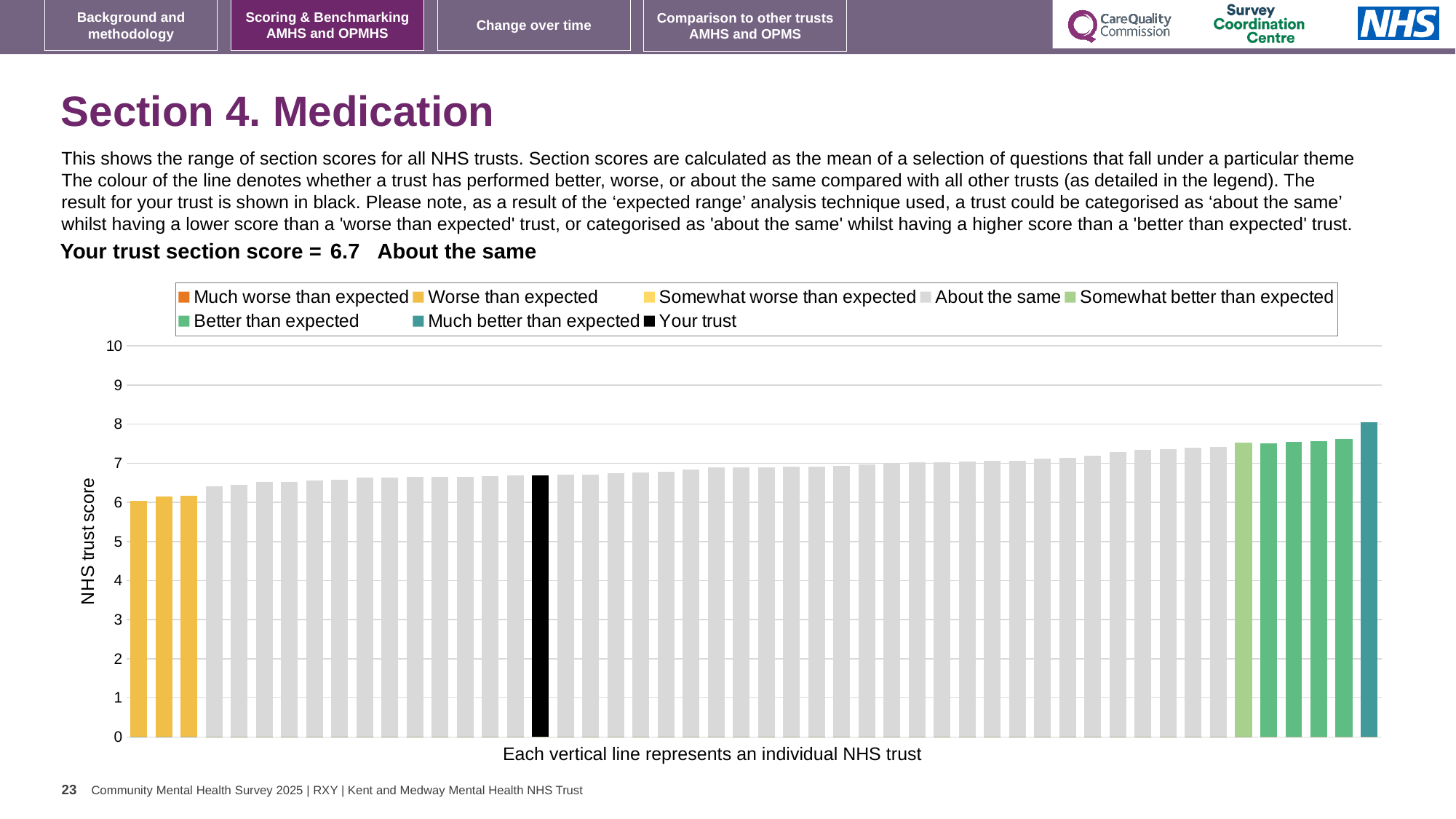
Is the value of the shortest bar (the leftmost bar) greater or less than 7? less How many bars are coloured as 'Worse than expected' (yellow)? 3 What is the section score for your trust shown on the slide? 6.7 Which category is your trust placed in for this section? About the same What is the label on the vertical axis of the chart? NHS trust score How many bars are coloured as 'Much better than expected' (teal)? 1 Do the bar values rise or fall from left to right along the x axis? rise Is the value of the tallest bar (the rightmost, teal bar) greater or less than 7? greater Is the value of the black bar (your trust) greater or less than 5? greater What kind of chart is shown on the slide? bar chart Which is larger, the leftmost bar or the rightmost bar? the rightmost bar How many entries does the chart legend list? 8